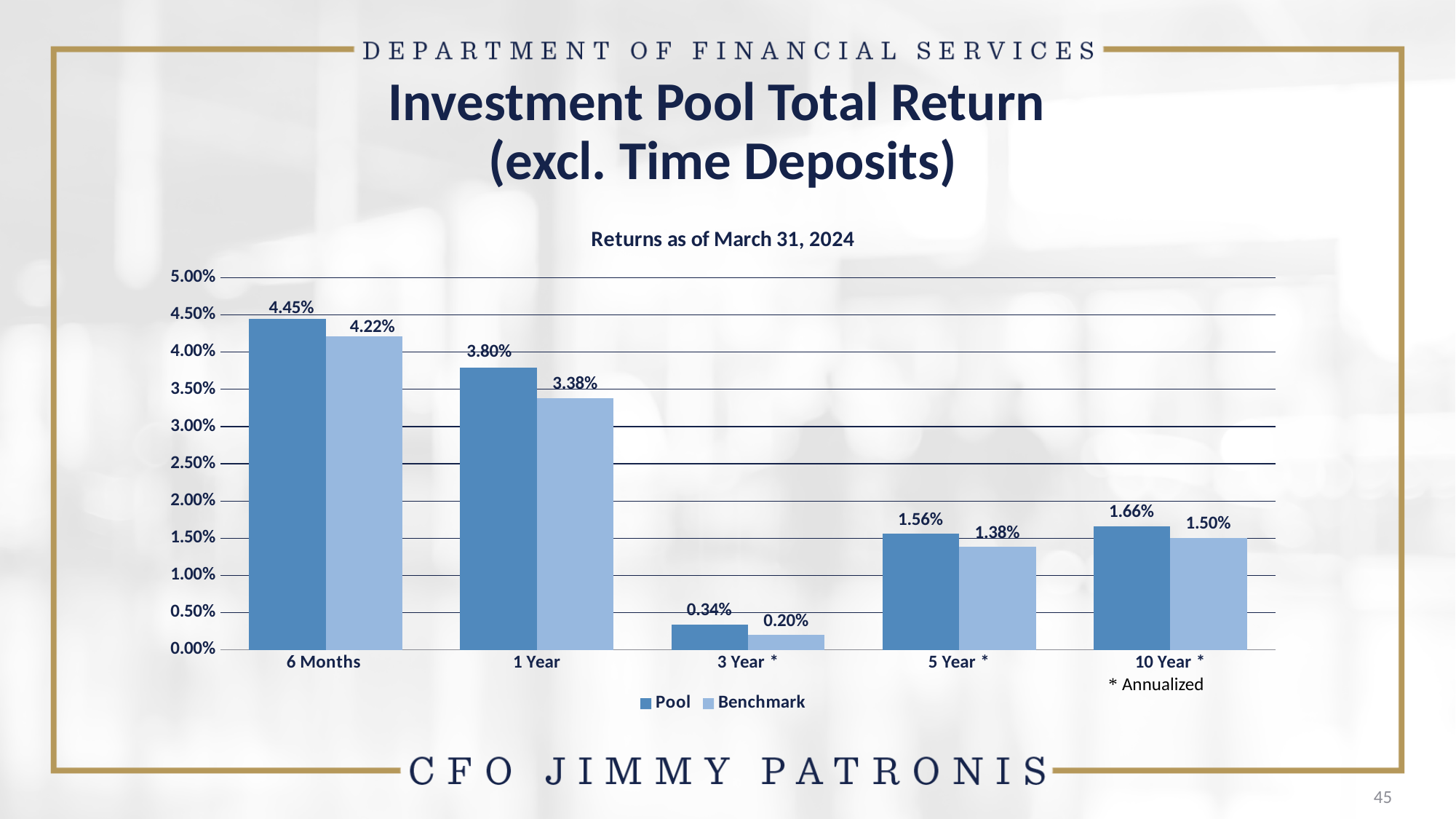
Which period has the lowest Benchmark return? 3 Year What is the Pool return for 3 Year? 0.34% What is the subtitle shown above the chart? Returns as of March 31, 2024 How many series does the legend list? 2 What kind of chart is shown on the slide? Bar chart What is the difference between the Pool and Benchmark returns for 1 Year? 0.42% What is the Benchmark return for 1 Year? 3.38% How many time periods are shown on the x axis? 5 What is the Benchmark return for 10 Year? 1.50% Which is larger for 5 Year, the Pool return or the Benchmark return? Pool What is the Pool return for 6 Months? 4.45% Which period has the highest Pool return? 6 Months